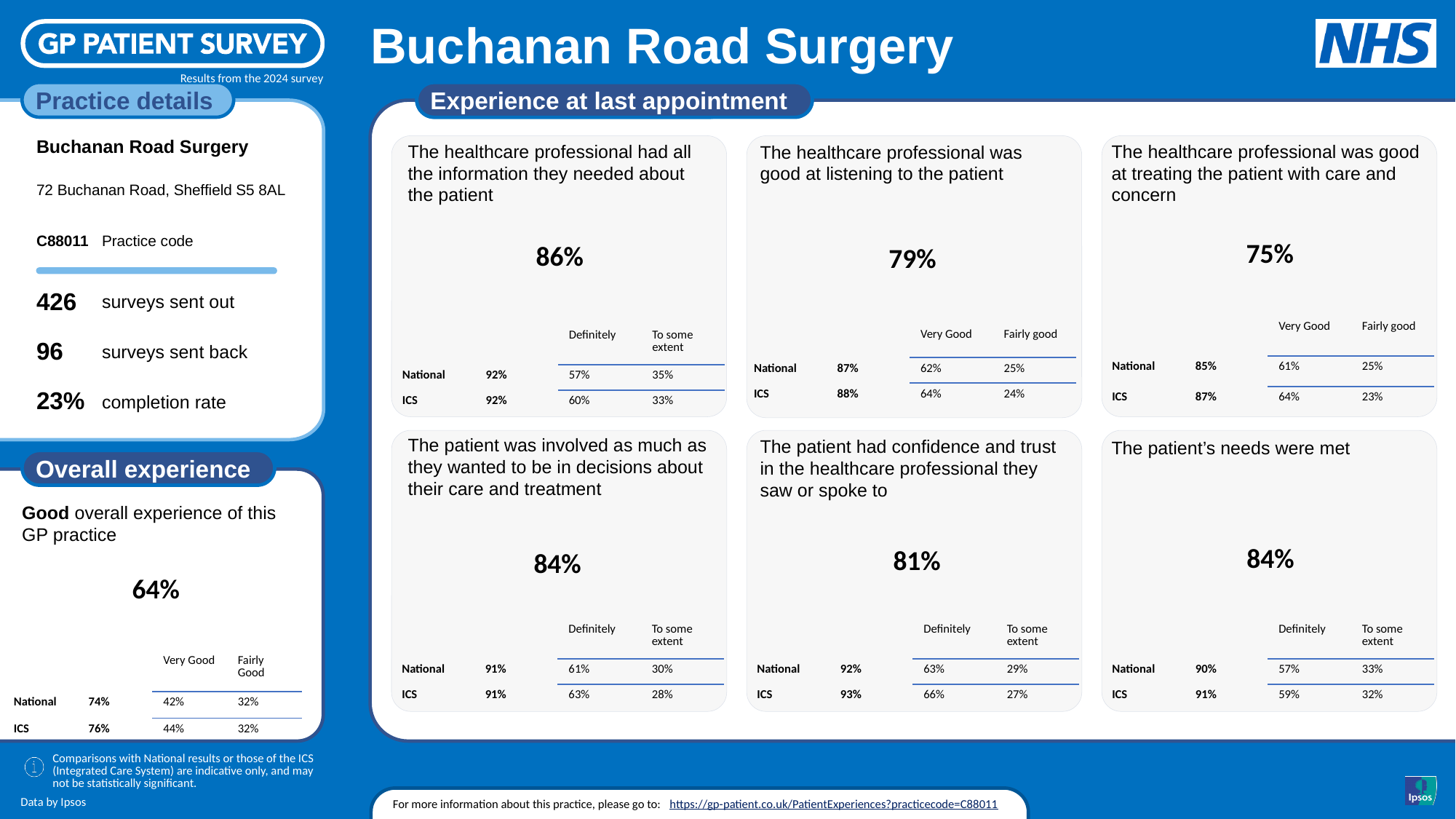
In the 'The patient had confidence and trust in the healthcare professional they saw or spoke to' panel, what is the difference between the ICS figure and the practice figure? 12% Among the six 'Experience at last appointment' measures, which has the lowest practice percentage? The healthcare professional was good at treating the patient with care and concern How many measures are shown in the 'Experience at last appointment' section? 6 In the 'Experience at last appointment' section, what is the practice's percentage for 'The healthcare professional was good at listening to the patient'? 79% In the 'The patient was involved as much as they wanted to be in decisions about their care and treatment' panel, which is larger: the practice figure or the National figure? National In the 'Experience at last appointment' section, what is the practice's percentage for 'The healthcare professional had all the information they needed about the patient'? 86% Among the six 'Experience at last appointment' measures, which has the highest practice percentage? The healthcare professional had all the information they needed about the patient In the 'Overall experience' panel, what is the National figure for good overall experience? 74% In the 'Overall experience' panel, what is the ICS 'Very Good' percentage? 44% In the 'The patient's needs were met' panel, what is the National 'Definitely' percentage? 57% In the 'Overall experience' panel, what percentage of patients reported a good overall experience of this GP practice? 64% In the 'Experience at last appointment' section, what is the practice's percentage for 'The healthcare professional was good at treating the patient with care and concern'? 75%